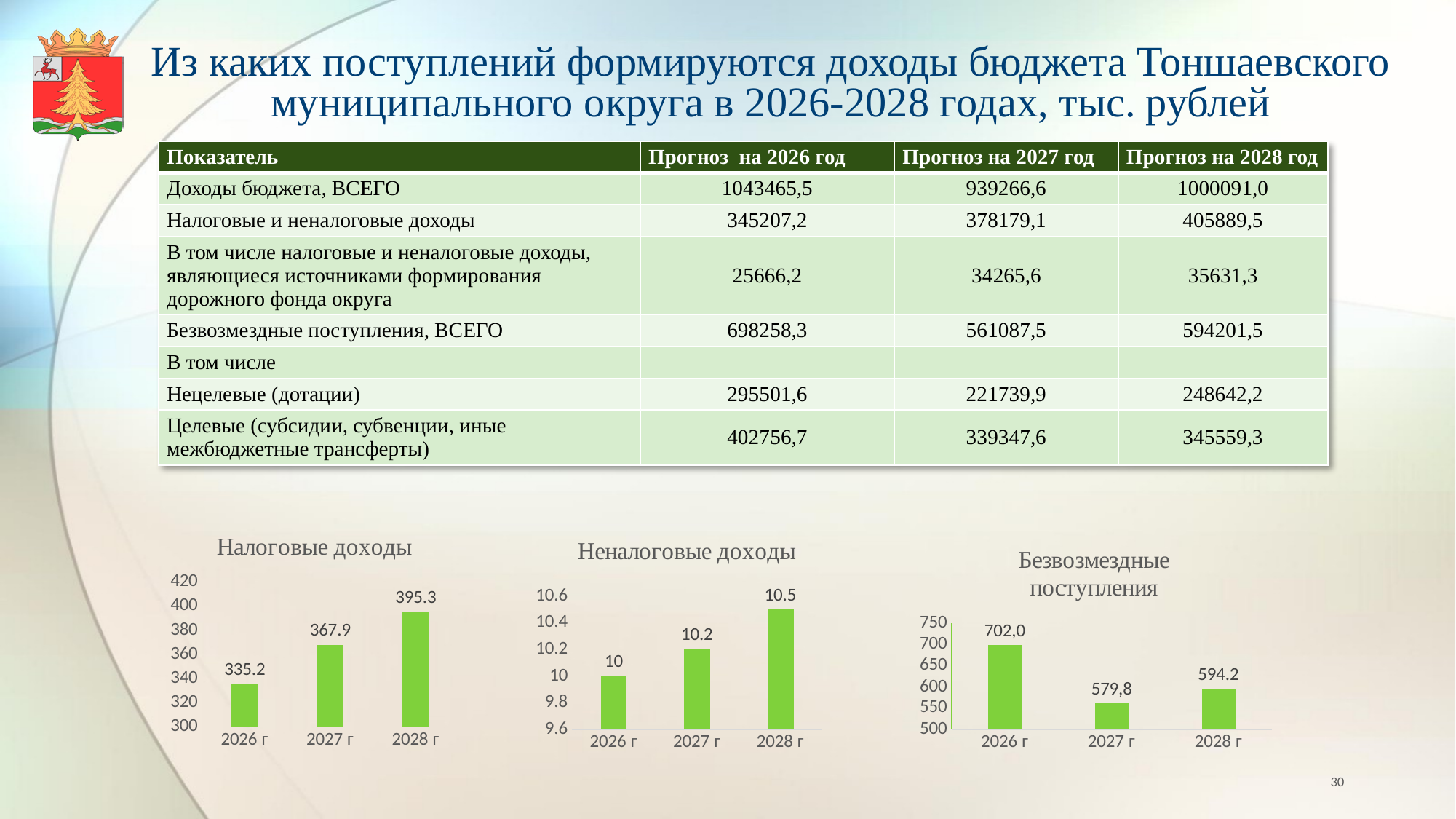
What kind of chart is the "Налоговые доходы" chart? bar chart In the "Безвозмездные поступления" chart, is the value for 2027 г greater or less than 600? less In the "Налоговые доходы" chart, do the values rise or fall from 2026 г to 2028 г? rise In the "Налоговые доходы" chart, what is the value for 2028 г? 395.3 In the "Безвозмездные поступления" chart, which year has the lowest value? 2027 г In the "Неналоговые доходы" chart, how many bars are plotted? 3 In the "Неналоговые доходы" chart, which year has the lowest value? 2026 г In the "Неналоговые доходы" chart, what is the value for 2027 г? 10.2 In the "Безвозмездные поступления" chart, what is the value for 2026 г? 702,0 In the "Налоговые доходы" chart, what is the difference between the 2028 г and 2026 г values? 60.1 In the "Налоговые доходы" chart, what is the value for 2026 г? 335.2 In the "Безвозмездные поступления" chart, which is larger, the value for 2027 г or for 2028 г? 2028 г